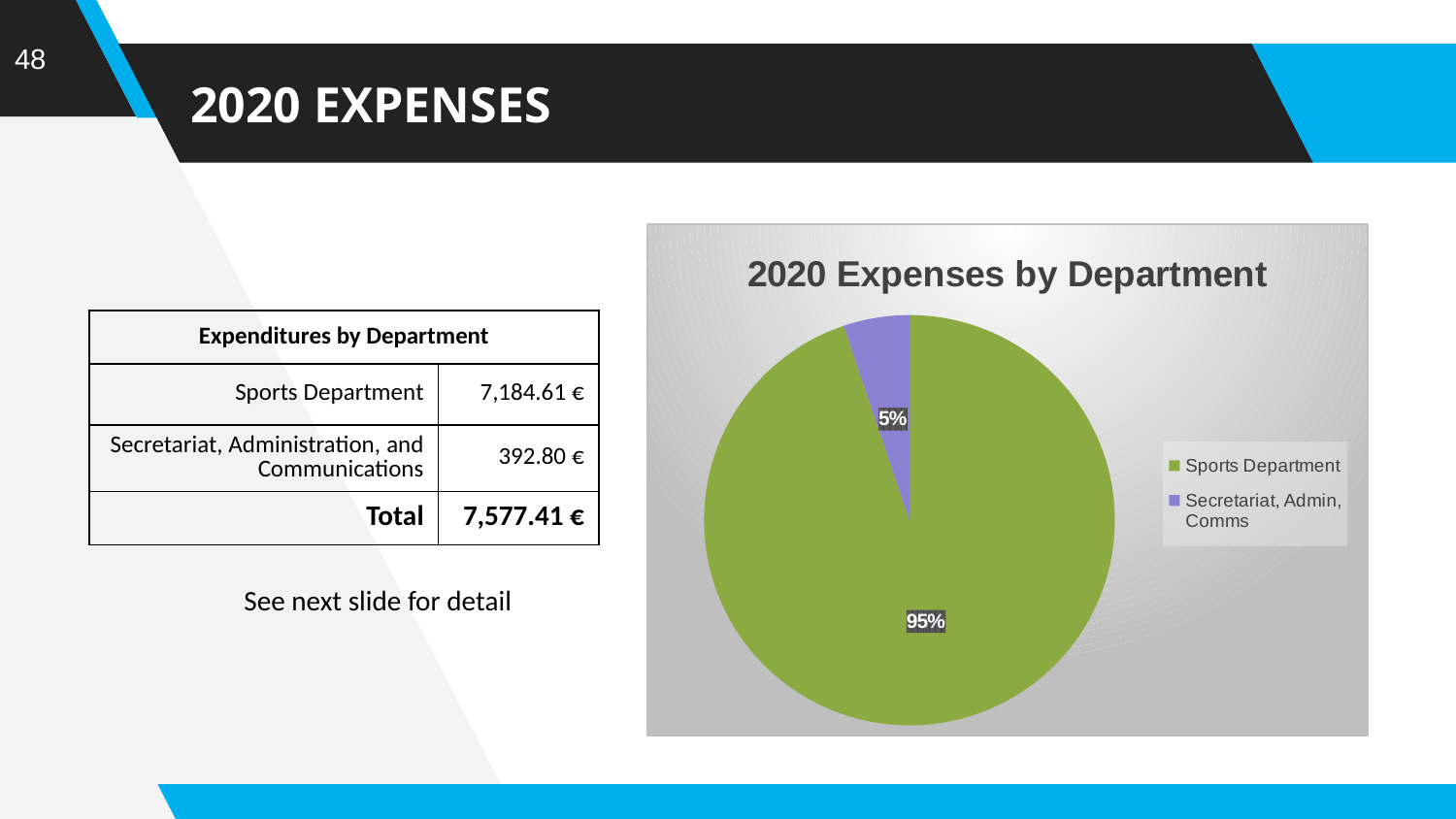
What share of the pie does the Sports Department slice represent? 95% Which department has the smallest slice of the pie? Secretariat, Admin, Comms Which department has the largest slice of the pie? Sports Department What colour is the Sports Department slice in the pie chart? green What is the difference in percentage points between the Sports Department share and the Secretariat, Admin, Comms share? 90 percentage points How many entries does the legend list? 2 How many slices does the pie chart have? 2 Which is larger, the Sports Department slice or the Secretariat, Admin, Comms slice? Sports Department What kind of chart is shown on the slide? pie chart What is the title of the chart? 2020 Expenses by Department What share of the pie does the Secretariat, Admin, Comms slice represent? 5%